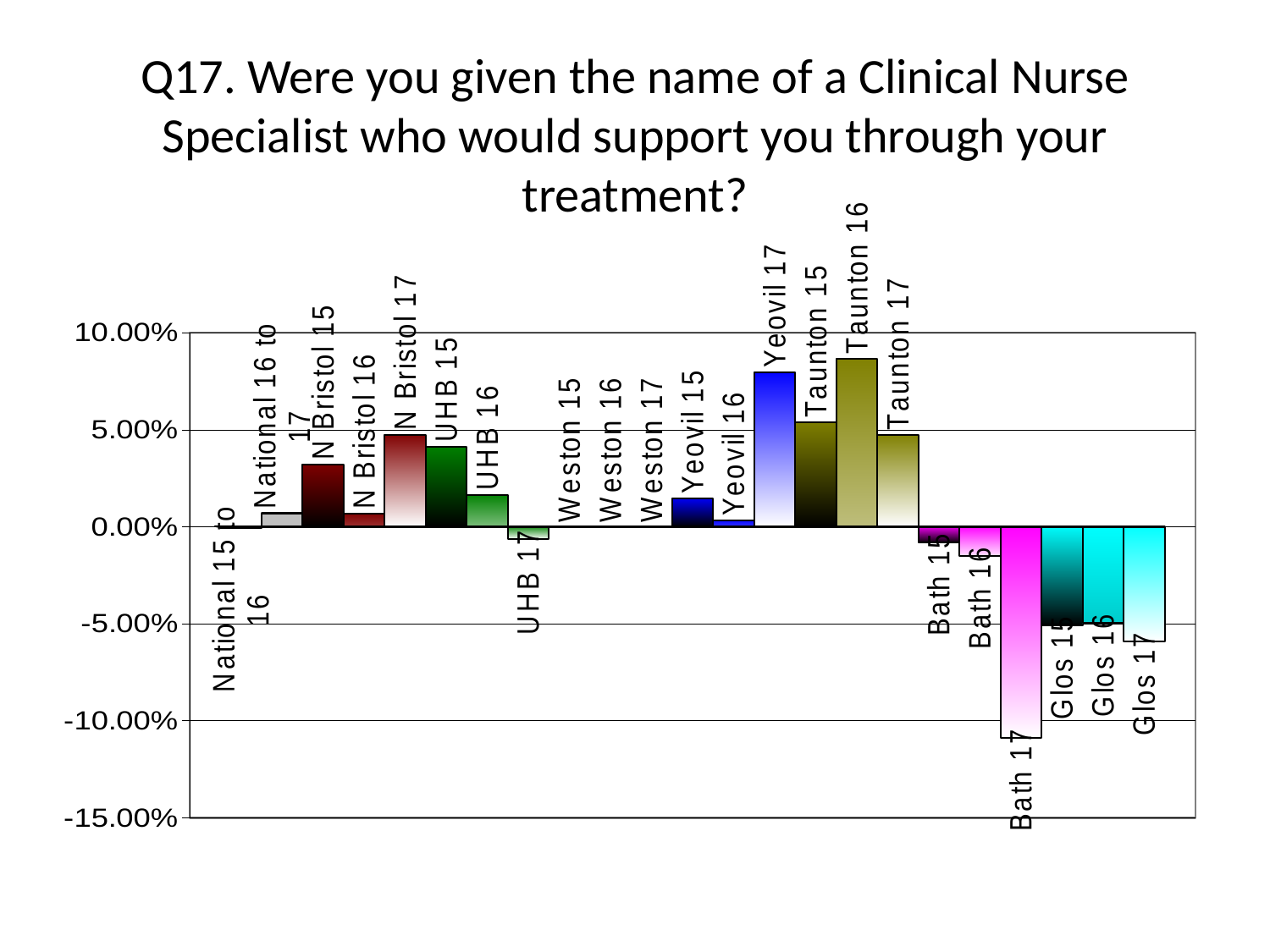
What kind of chart is shown on the slide? Bar chart Is the value for Bath 17 greater or less than -10.00%? less How many categories are plotted in the chart? 23 Which category has the lowest value in the chart? Bath 17 What is the title of the chart on the slide? Q17. Were you given the name of a Clinical Nurse Specialist who would support you through your treatment? Is the value for Yeovil 17 greater or less than 5.00%? greater Is the value for N Bristol 15 greater or less than 5.00%? less Which category has the highest value in the chart? Taunton 16 Which is larger, the value for Bath 17 or the value for Glos 17? Glos 17 Which is larger, the value for Yeovil 17 or the value for Yeovil 15? Yeovil 17